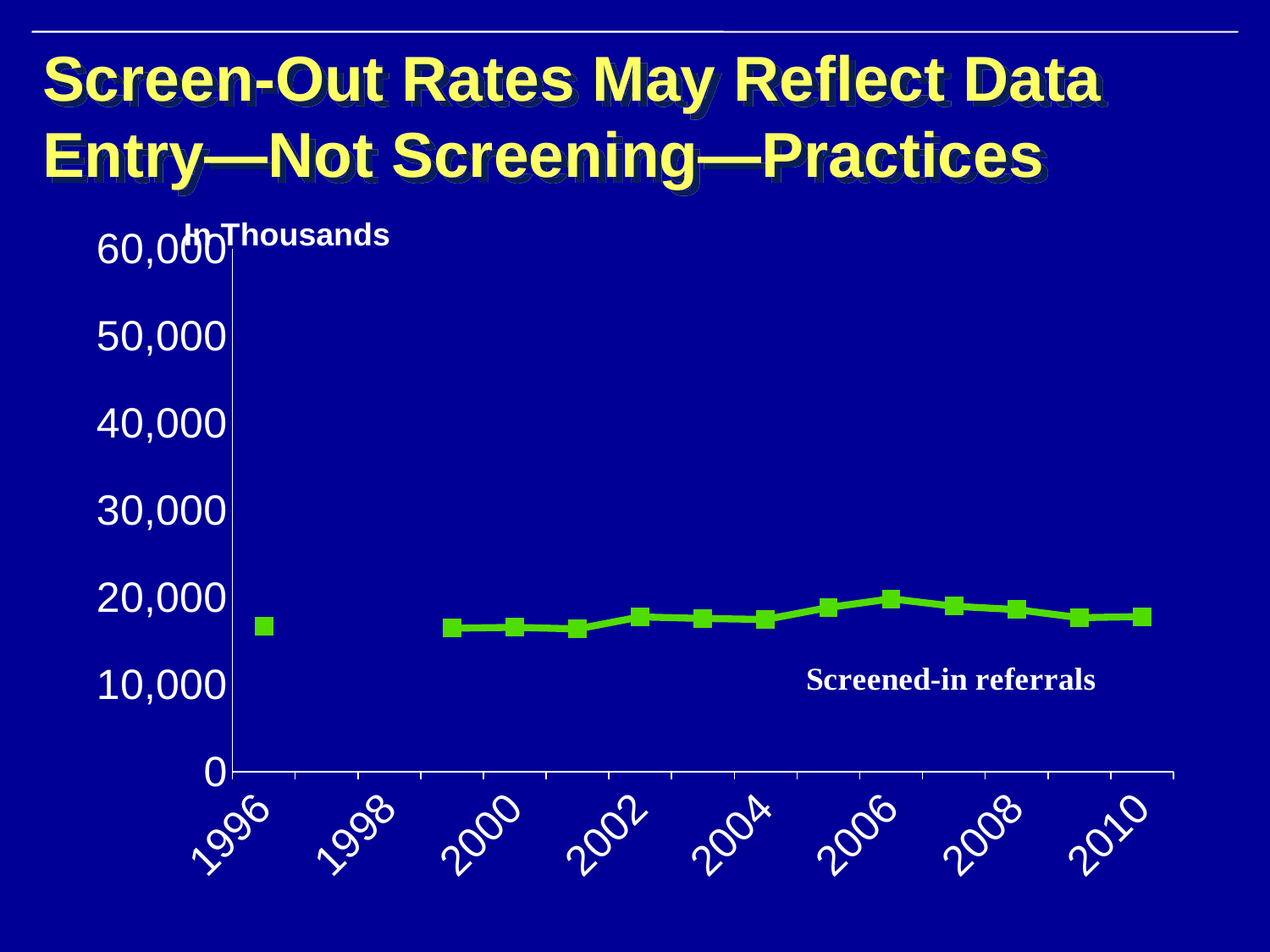
Is the value for Screened-in referrals in 2006 greater or less than 30,000? less How many data series are plotted on the chart? 1 What kind of chart is shown on the slide? line chart What unit label is shown at the top of the y axis? In Thousands What is the name of the data series plotted on the chart? Screened-in referrals Is the value for Screened-in referrals in 1996 greater or less than 20,000? less Which year has the larger value for Screened-in referrals, 2006 or 1996? 2006 What is the highest value shown on the y axis? 60,000 Is the value for Screened-in referrals in 2006 greater or less than 10,000? greater In which year does the Screened-in referrals line reach its highest point? 2006 Between 2006 and 2009, do the Screened-in referrals values rise or fall? fall